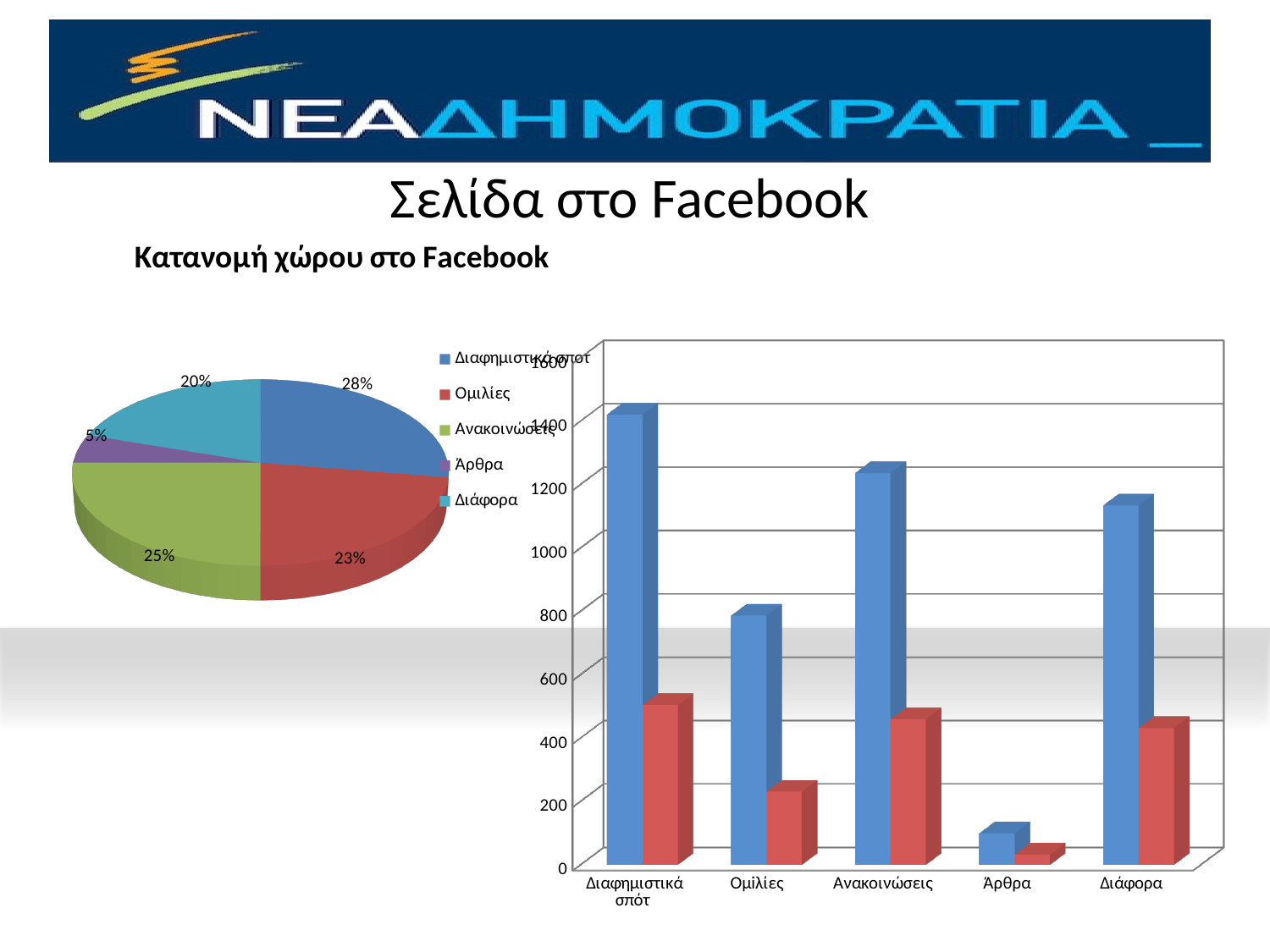
What kind of chart is the chart on the right of the slide? Bar chart On the bar chart on the right, is the blue bar for Ομιλίες greater or less than 1000? less On the pie chart, what percentage is shown for Ανακοινώσεις? 25% On the pie chart, how many entries does the legend list? 5 On the pie chart, which category has the smallest share? Άρθρα On the bar chart on the right, is the blue bar for Διαφημιστικά σποτ greater or less than 1200? greater On the bar chart on the right, how many categories are shown on the x axis? 5 On the pie chart, what percentage is shown for Διαφημιστικά σποτ? 28% On the pie chart, what percentage is shown for Άρθρα? 5% On the bar chart on the right, which category has the tallest blue bar? Διαφημιστικά σποτ On the pie chart, which category has the largest share? Διαφημιστικά σποτ On the pie chart, what is the difference in percentage points between Διαφημιστικά σποτ and Ομιλίες? 5